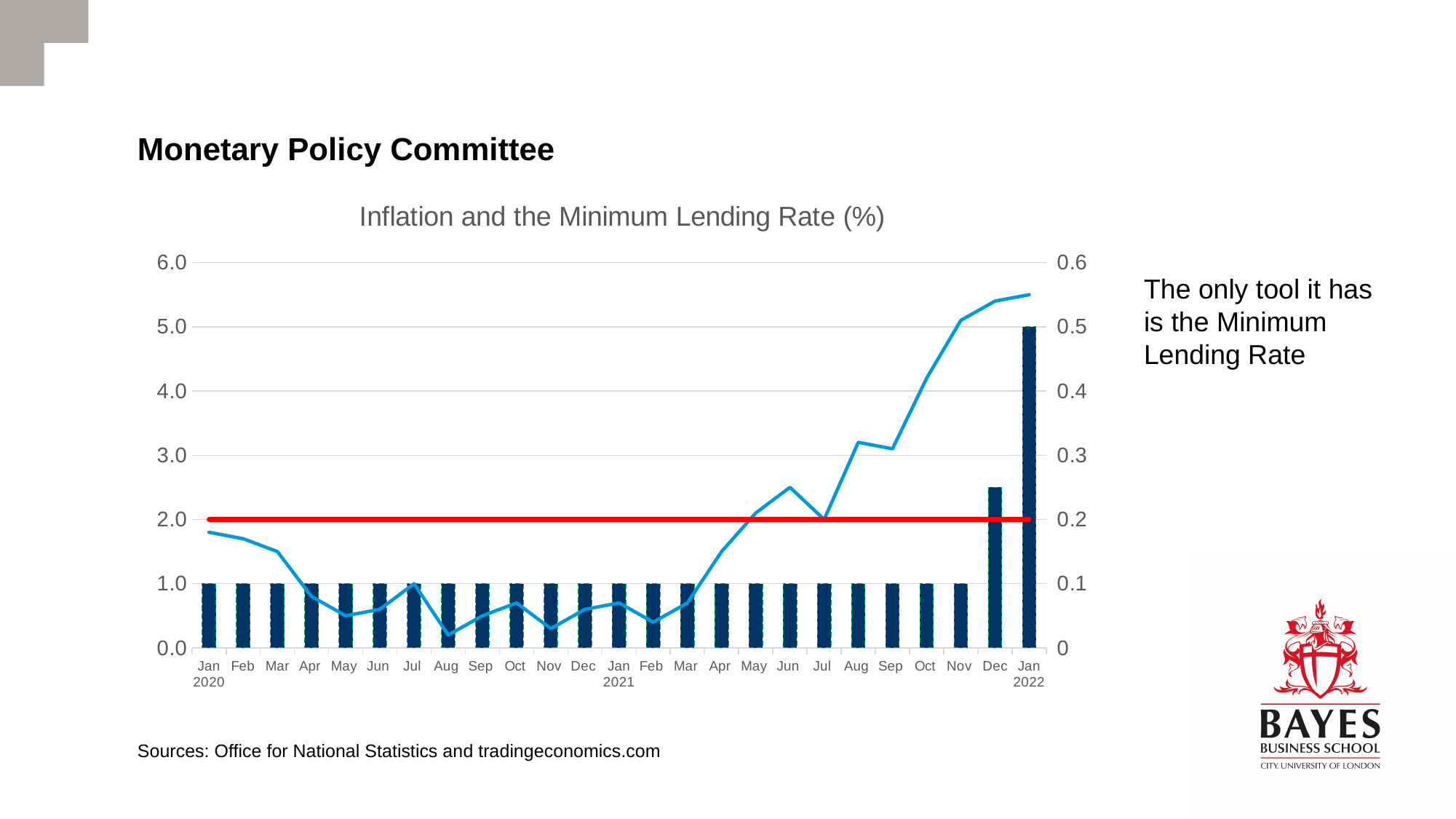
Is the bar for Dec 2021 or the bar for Jan 2022 taller? Jan 2022 Is the value of the blue line for Jan 2022 greater or less than 5.0 on the left-hand axis? greater How many months are shown along the x axis of the chart? 25 What is the value of the bar for Jan 2020 on the right-hand axis? 0.1 What kind of chart is shown on the slide? Combined bar and line chart Is the value of the blue line for Aug 2020 greater or less than 1.0 on the left-hand axis? less What is the title of the chart? Inflation and the Minimum Lending Rate (%) What is the value of the bar for Jan 2022 on the right-hand axis? 0.5 Which month has the tallest bar? Jan 2022 What is the difference between the bar values for Jan 2022 and Jan 2020 on the right-hand axis? 0.4 Does the blue line rise or fall between Mar 2021 and Jan 2022? rise At what level on the left-hand axis is the horizontal red line drawn? 2.0